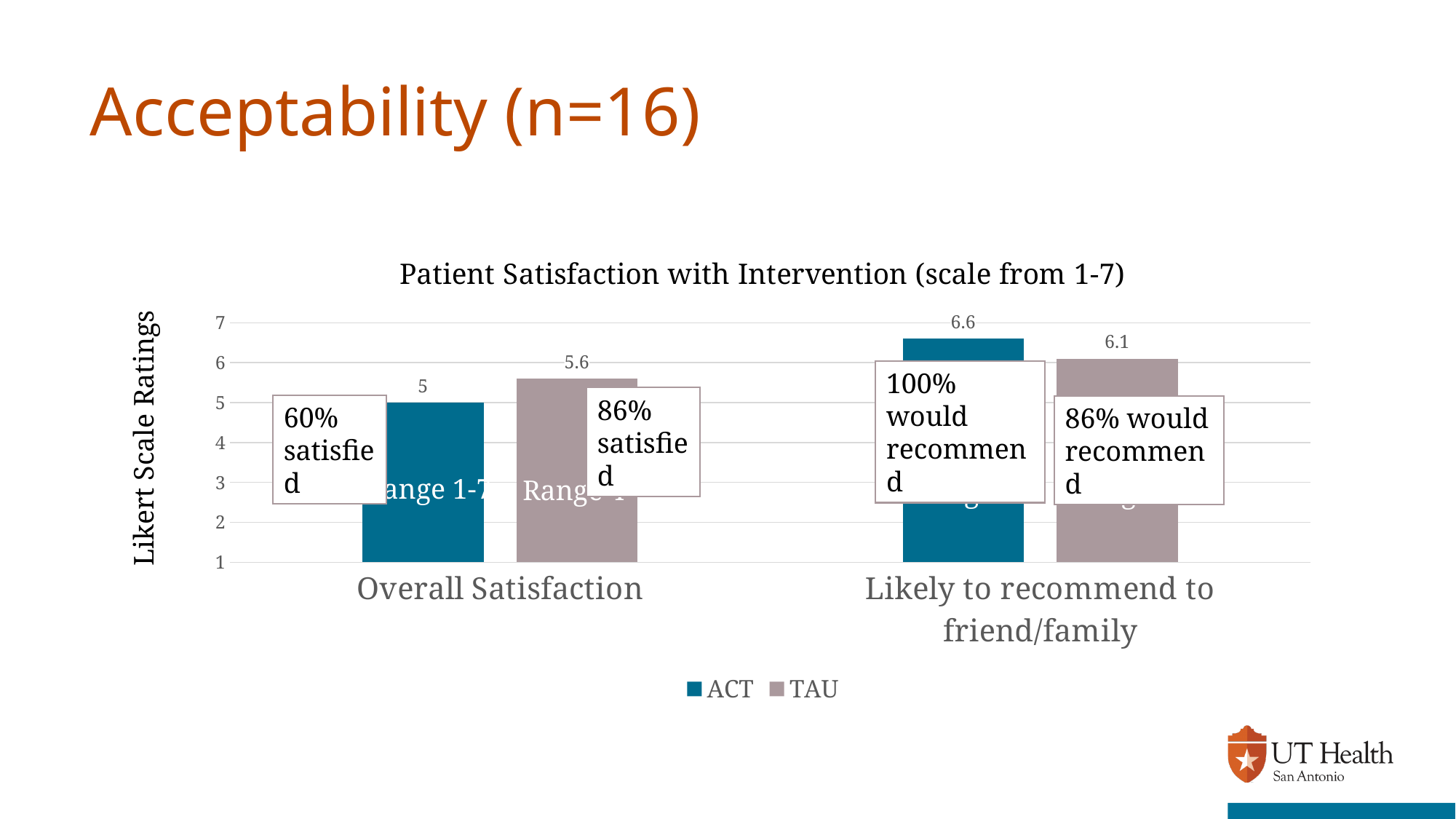
How many series does the legend list? 2 Which series has the higher value for Overall Satisfaction, ACT or TAU? TAU What is the ACT value for Likely to recommend to friend/family? 6.6 What is the title of the chart? Patient Satisfaction with Intervention (scale from 1-7) What is the TAU value for Likely to recommend to friend/family? 6.1 Which bar has the highest value in the chart? ACT, Likely to recommend to friend/family What type of chart is shown? Bar chart Which series has the higher value for Likely to recommend to friend/family, ACT or TAU? ACT What is the difference between the TAU and ACT values for Overall Satisfaction? 0.6 What is the ACT value for Overall Satisfaction? 5 What is the TAU value for Overall Satisfaction? 5.6 What is the difference between the ACT and TAU values for Likely to recommend to friend/family? 0.5